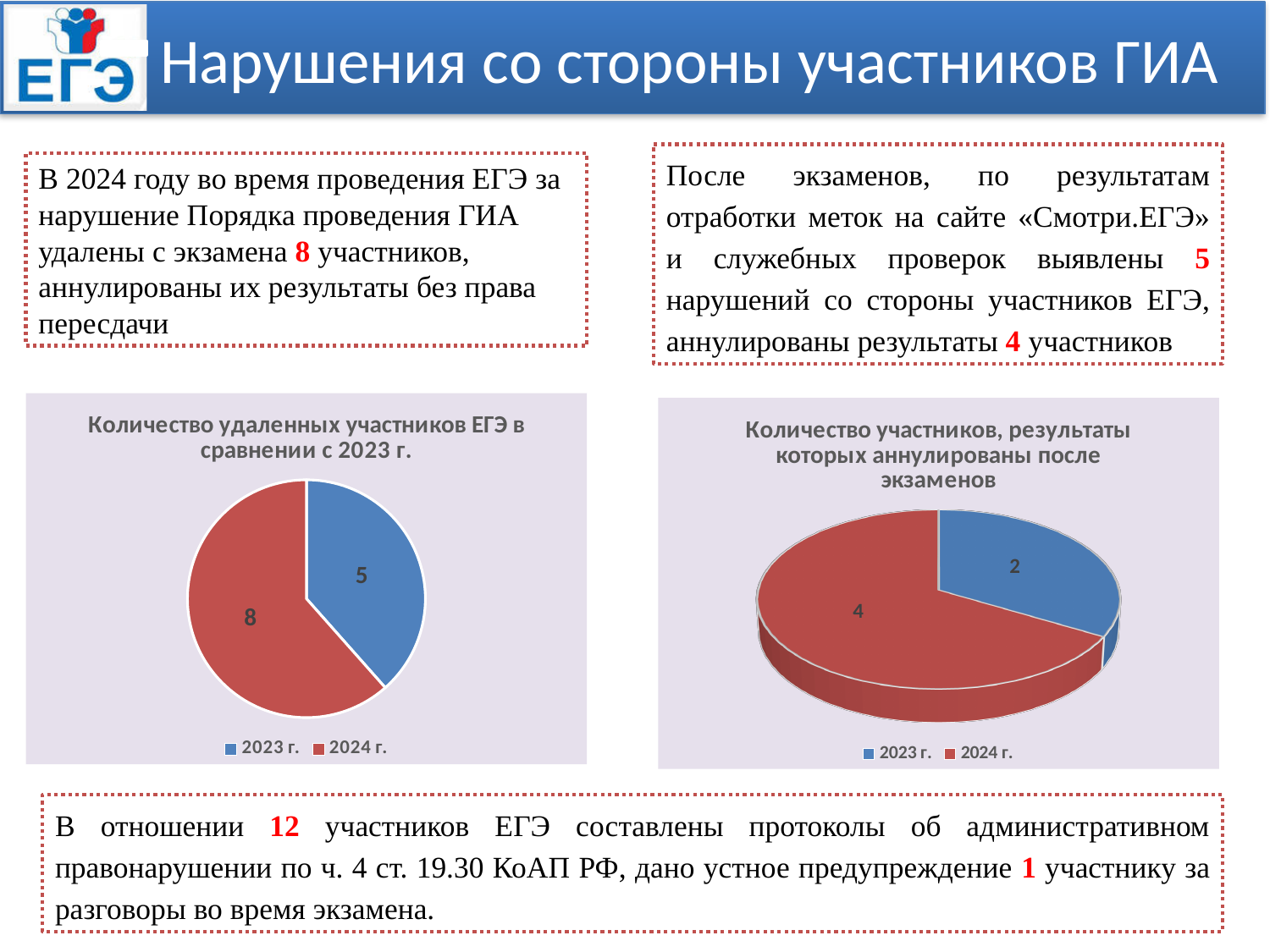
In the right chart, what is the difference between the values for 2024 г. and 2023 г.? 2 In the right chart, which year has the smaller slice? 2023 г. In the left chart 'Количество удаленных участников ЕГЭ в сравнении с 2023 г.', what is the value for 2023 г.? 5 In the left chart, what is the difference between the values for 2024 г. and 2023 г.? 3 In the right chart, is the value for 2024 г. larger or smaller than the value for 2023 г.? larger In the left chart, which year has the larger slice? 2024 г. In the left chart, what colour is the slice for 2023 г.? blue In the right chart 'Количество участников, результаты которых аннулированы после экзаменов', what is the value for 2023 г.? 2 In the left chart 'Количество удаленных участников ЕГЭ в сравнении с 2023 г.', what is the value for 2024 г.? 8 What type of chart is the left chart on the slide? pie chart How many entries does the legend of the right chart list? 2 In the right chart 'Количество участников, результаты которых аннулированы после экзаменов', what is the value for 2024 г.? 4